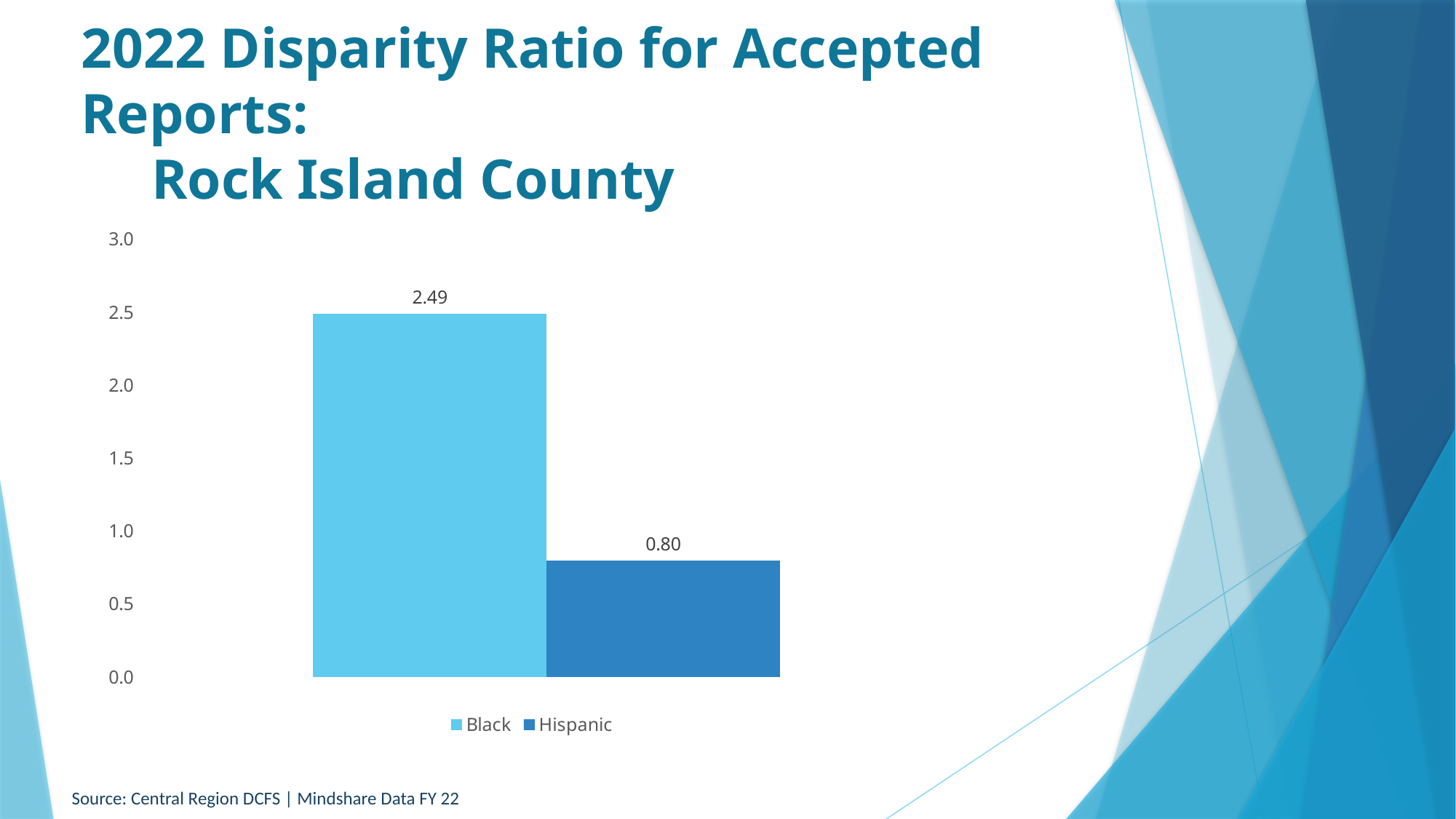
Is the disparity ratio for Hispanic greater or less than 1.0? less Is the value for Hispanic larger than the value for Black? No Which legend entry is shown in the lighter blue colour? Black What is the disparity ratio for Hispanic in the chart? 0.80 How many series does the legend list? 2 Is the disparity ratio for Black greater or less than 2.0? greater What is the highest value shown on the vertical axis? 3.0 Which group has the lower disparity ratio? Hispanic What kind of chart is shown on the slide? Bar chart What is the difference between the Black and Hispanic disparity ratios? 1.69 What is the disparity ratio for Black in the chart? 2.49 Which group has the higher disparity ratio? Black